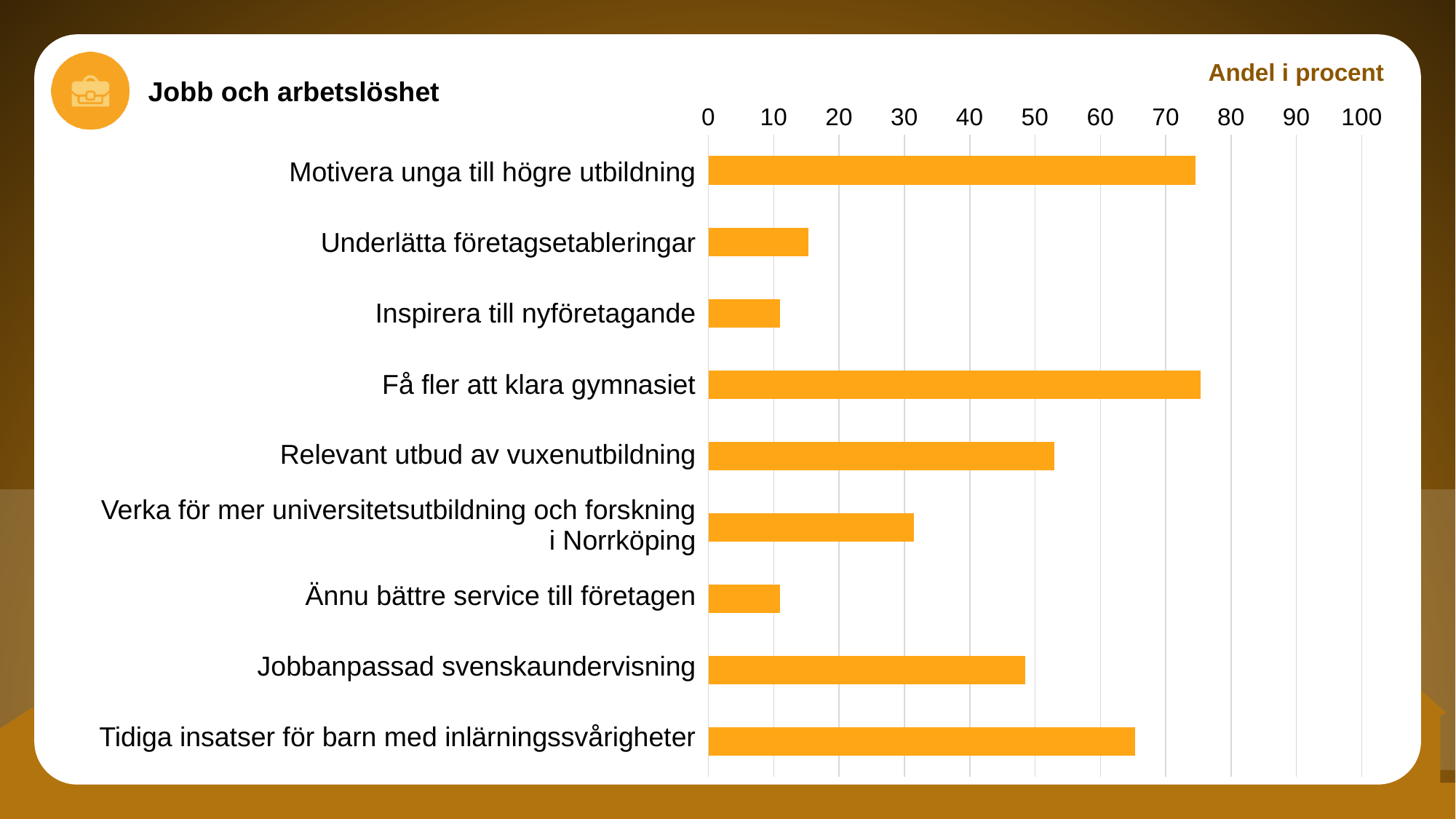
Is the value for 'Verka för mer universitetsutbildning och forskning i Norrköping' greater or less than 40? less Which has a larger value: 'Tidiga insatser för barn med inlärningssvårigheter' or 'Relevant utbud av vuxenutbildning'? Tidiga insatser för barn med inlärningssvårigheter Is the value for 'Relevant utbud av vuxenutbildning' greater or less than 50? greater Is the value for 'Få fler att klara gymnasiet' greater or less than 70? greater What is the label shown above the value axis of the chart? Andel i procent How many categories are plotted in the chart? 9 Which has a larger value: 'Verka för mer universitetsutbildning och forskning i Norrköping' or 'Underlätta företagsetableringar'? Verka för mer universitetsutbildning och forskning i Norrköping What is the highest tick value shown on the value axis? 100 What kind of chart is shown on the slide? bar chart